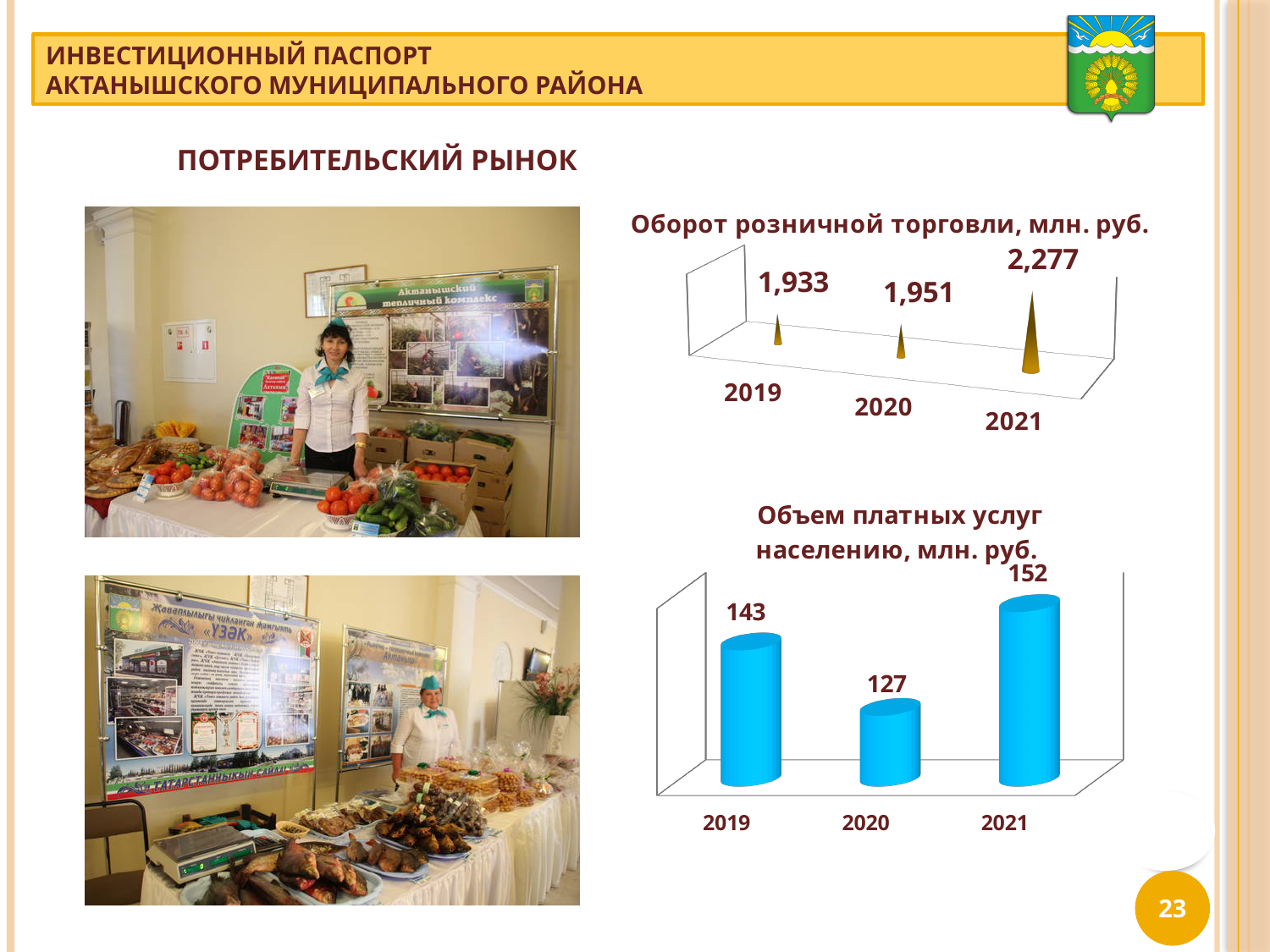
In the chart 'Оборот розничной торговли, млн. руб.', do the values rise or fall from 2019 to 2021? rise In the chart 'Оборот розничной торговли, млн. руб.', what is the value for 2019? 1,933 In the chart 'Оборот розничной торговли, млн. руб.', what is the difference between the 2021 and 2019 values? 344 In the chart 'Оборот розничной торговли, млн. руб.', what is the value for 2021? 2,277 In the chart 'Объем платных услуг населению, млн. руб.', which year has the lowest value? 2020 In the chart 'Объем платных услуг населению, млн. руб.', which year has the highest value? 2021 In the chart 'Объем платных услуг населению, млн. руб.', what is the value for 2020? 127 In the chart 'Объем платных услуг населению, млн. руб.', which is larger, the value for 2019 or the value for 2020? 2019 What kind of chart is 'Объем платных услуг населению, млн. руб.'? bar chart In the chart 'Оборот розничной торговли, млн. руб.', which year has the lowest value? 2019 In the chart 'Объем платных услуг населению, млн. руб.', what is the difference between the 2021 and 2020 values? 25 In the chart 'Оборот розничной торговли, млн. руб.', how many years are shown? 3